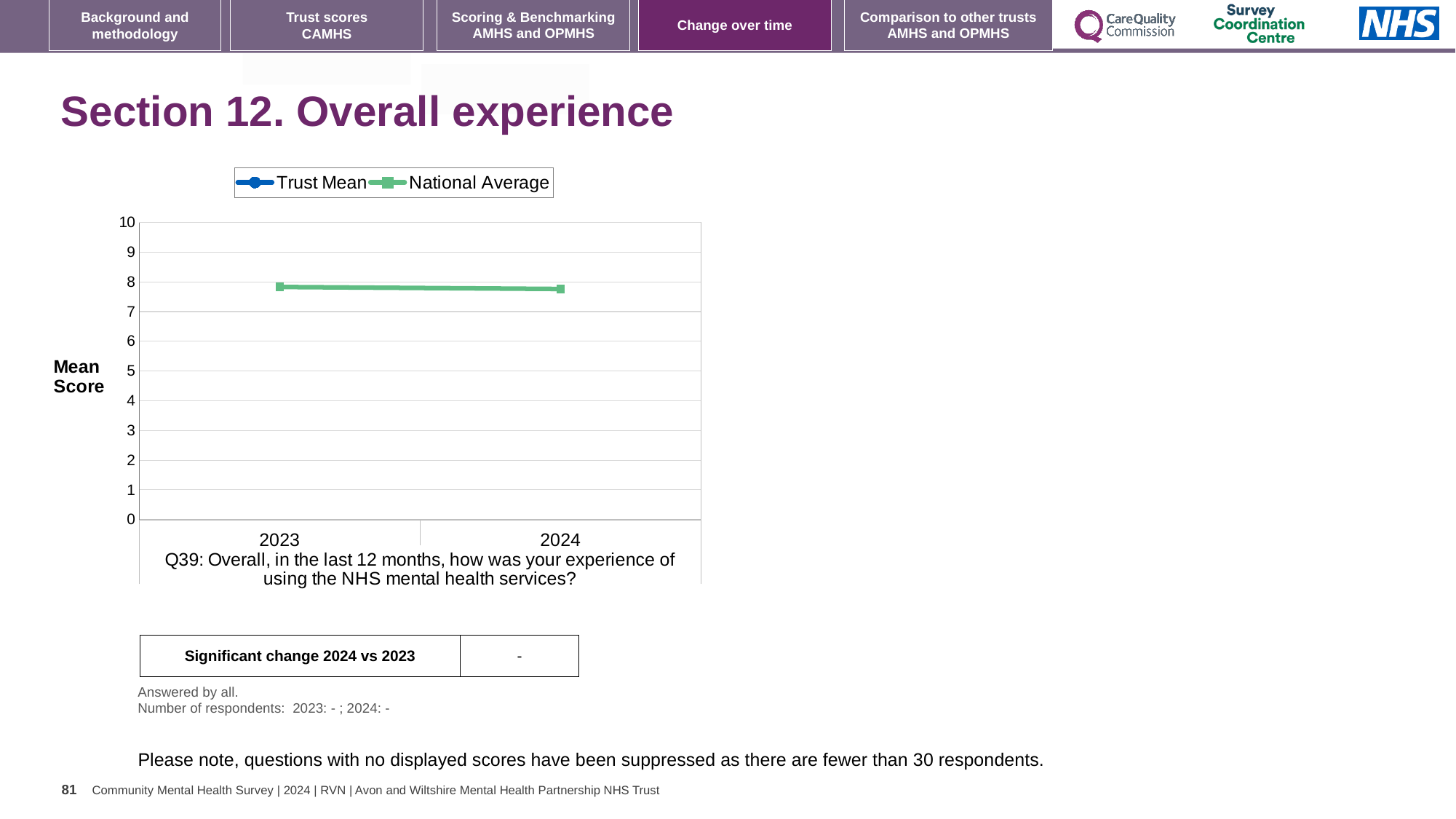
How many series does the chart legend list? 2 Is the National Average value for 2024 greater or less than 9? less What kind of chart is shown on the slide? line chart Is the National Average value for 2023 greater or less than 7? greater What is the label on the y axis of the chart? Mean Score Which series are listed in the chart legend? Trust Mean and National Average What is the maximum value shown on the y axis of the chart? 10 How many years are shown on the x axis of the chart? 2 Is the National Average value for 2023 greater or less than 9? less